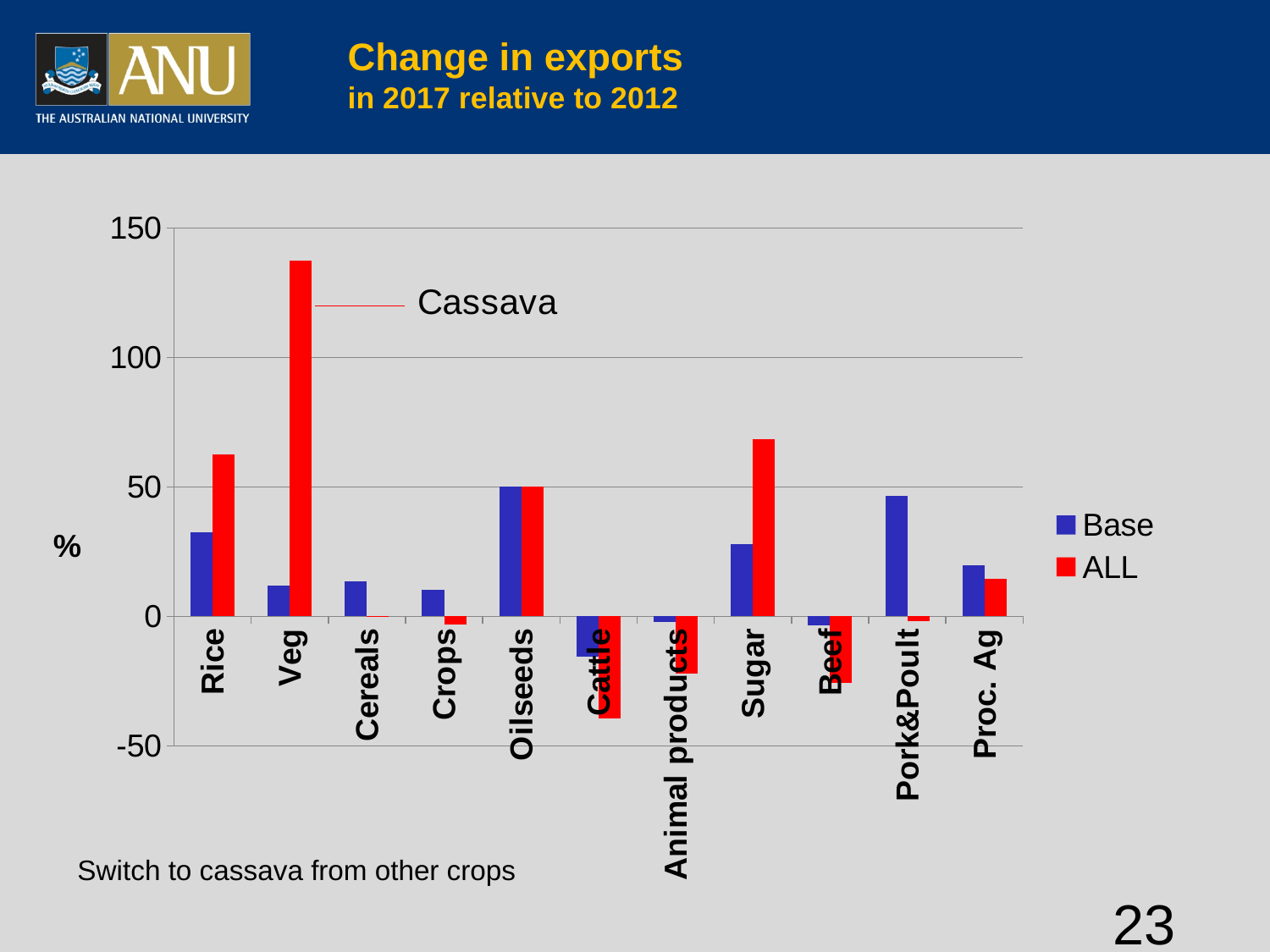
How many series does the legend list? 2 Is the ALL value for Veg greater or less than 100? greater What kind of chart is shown on the slide? bar chart Is the Base value for Rice greater or less than 50? less For Rice, which series has the larger value, Base or ALL? ALL Is the ALL value for Sugar greater or less than 50? greater How many categories are shown on the x axis? 11 For Pork&Poult, which series has the larger value, Base or ALL? Base Which category has the highest value for the ALL series? Veg Which bar does the 'Cassava' annotation point to? the ALL bar for Veg Which category has the lowest value for the ALL series? Cattle